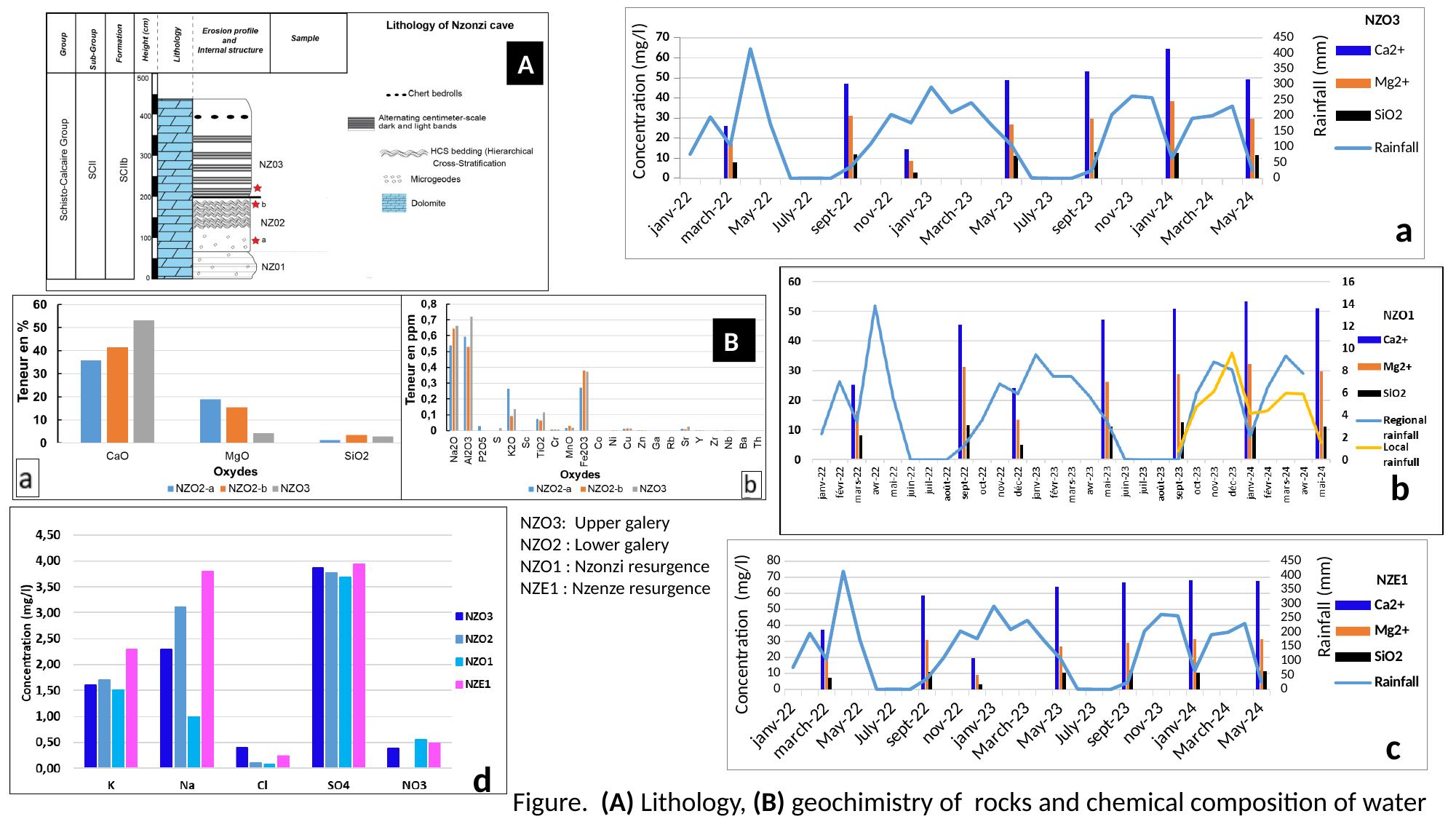
In the bottom-left chart (d) with K, Na, Cl, SO4 and NO3, how many series does the legend list? 4 In the Oxydes chart in percent (B, a), is the CaO value for NZO3 greater or less than 50%? greater What kind of chart is the NZE1 chart (c, bottom right)? Combined bar and line chart In the NZO3 chart (a, top right), is the Ca2+ value for janv-24 greater or less than 60 mg/l? greater In the Oxydes chart in percent (B, a), which series has the highest CaO value? NZO3 In the bottom-left chart (d), is the Na concentration for NZE1 greater or less than 3,50 mg/l? greater In the Oxydes chart in percent (B, a), which series has the highest MgO value? NZO2-a In the bottom-left chart (d), which series has the lowest Na concentration? NZO1 In the bottom-left chart (d), how many ion categories are shown on the x axis? 5 In the NZO1 chart (b, middle right), how many series does the legend list? 5 In the bottom-left chart (d), which series has the highest Na concentration? NZE1